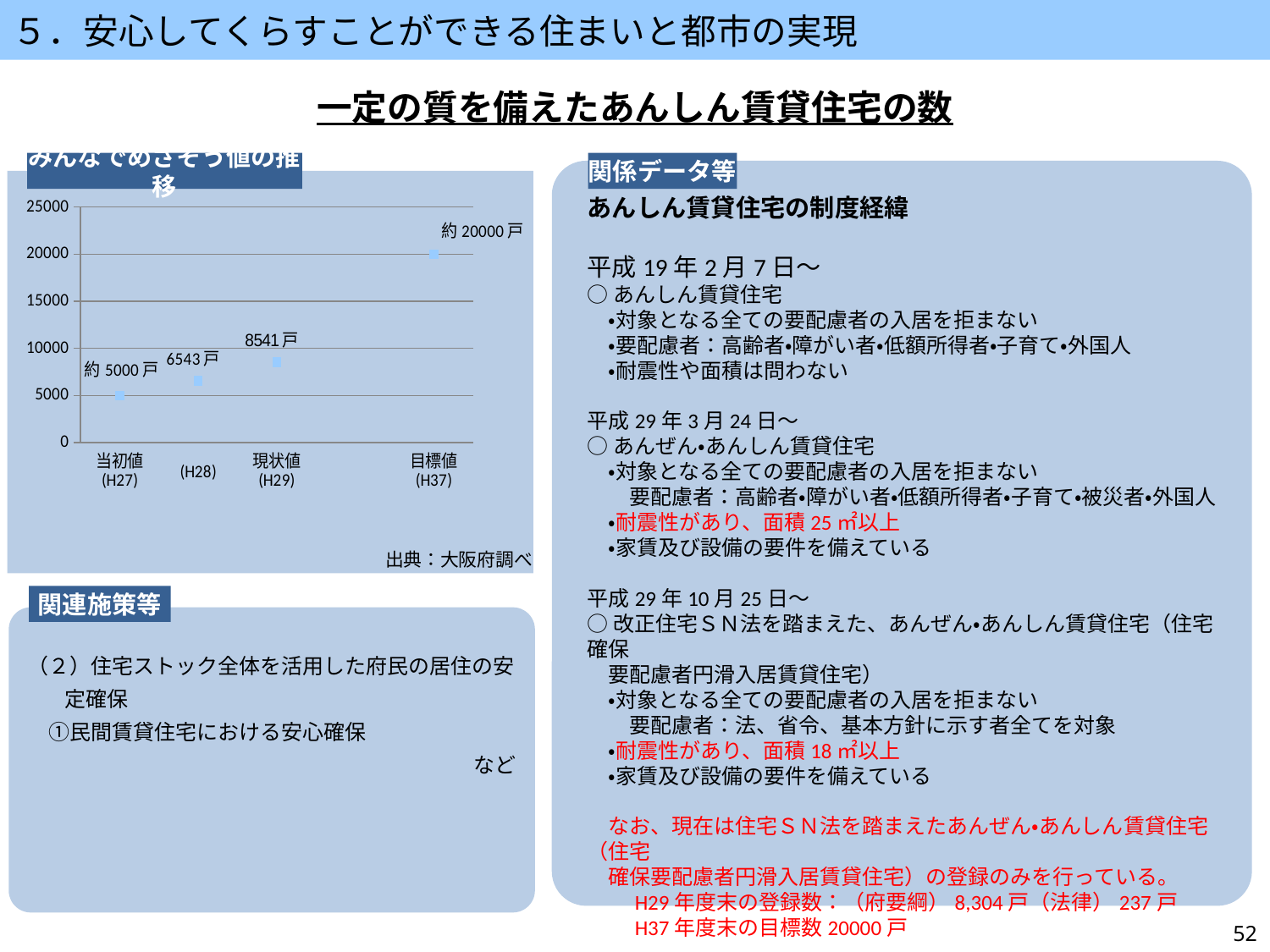
Which category has the lowest value in the chart? 当初値 (H27) What is the value shown for (H28) in the chart? 6543 戸 Is the value for 現状値 (H29) greater or less than 10000? less What is the source noted below the chart? 出典：大阪府調べ Which is larger, the value for (H28) or the value for 現状値 (H29)? 現状値 (H29) Do the values rise or fall from 当初値 (H27) to 目標値 (H37)? rise How many data points are plotted in the chart? 4 What is the difference between the values for 現状値 (H29) and (H28)? 1998 戸 Which category has the highest value in the chart? 目標値 (H37) What is the data label shown for 目標値 (H37) in the chart? 約 20000 戸 What is the data label shown for 当初値 (H27) in the chart? 約 5000 戸 What is the value shown for 現状値 (H29) in the chart? 8541 戸